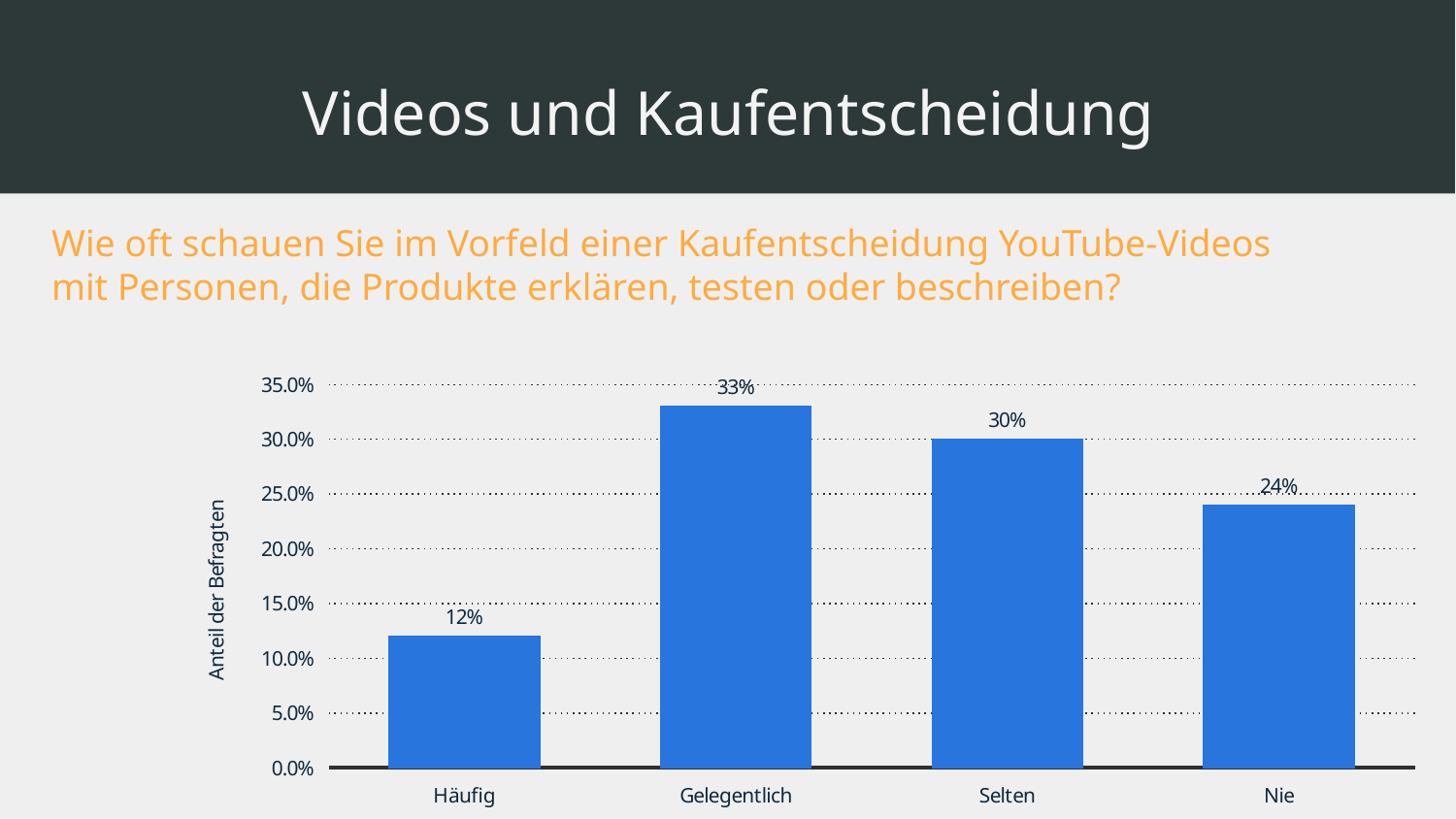
What is the difference between the values for Selten and Nie? 6% Which category has the highest value? Gelegentlich What kind of chart is shown on the slide? bar chart Is the value for Nie greater or less than 20.0%? greater What is the difference between the values for Gelegentlich and Häufig? 21% Which is larger, the value for Selten or the value for Nie? Selten What is the value for Gelegentlich? 33% How many categories are shown on the x axis? 4 What is the value for Nie? 24% What is the value for Selten? 30% What is the value for Häufig? 12% Which category has the lowest value? Häufig